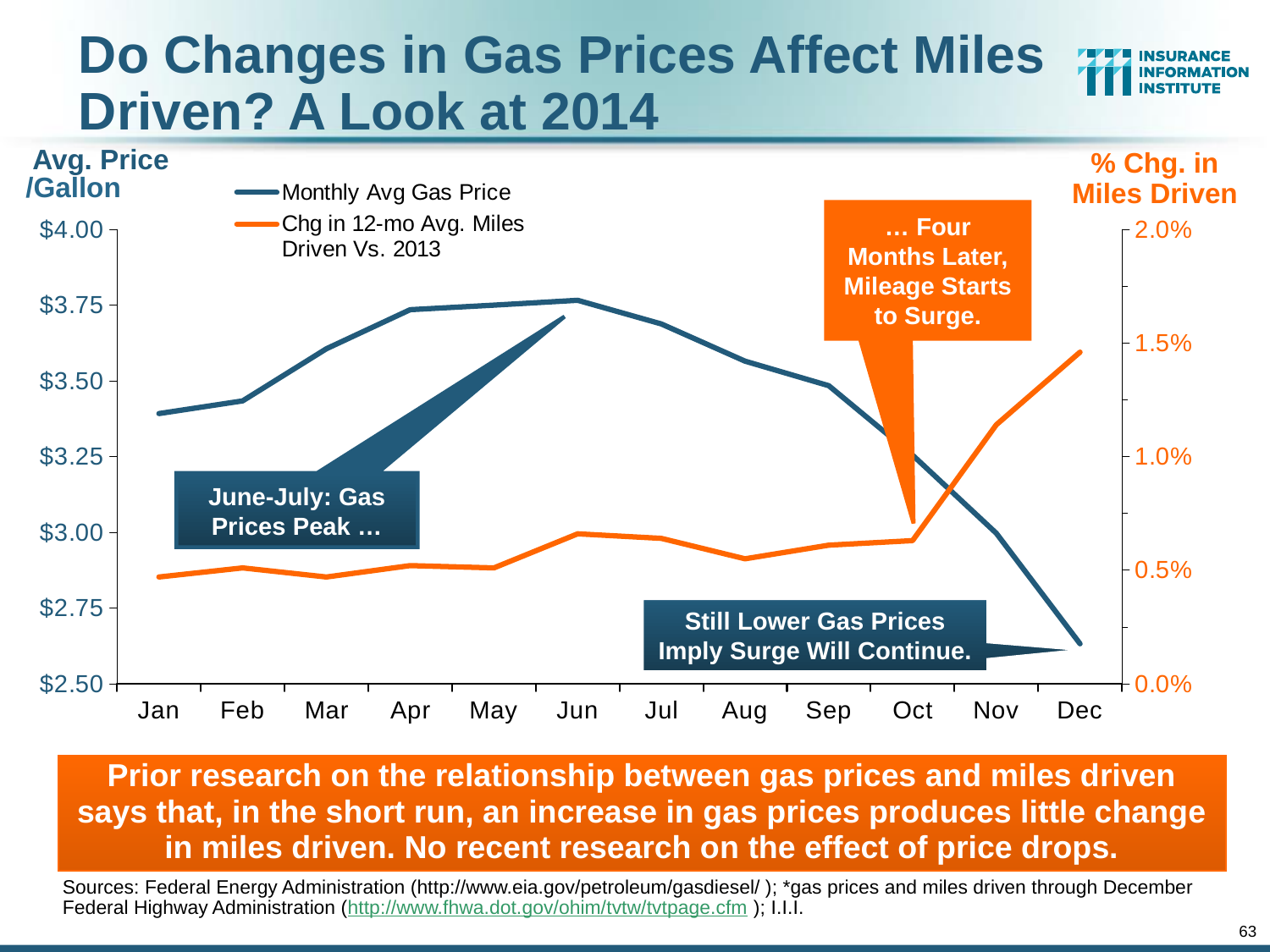
What kind of chart is shown on the slide? line chart Is the Chg in 12-mo Avg. Miles Driven Vs. 2013 for Oct greater or less than 1.0%? less How many series does the legend list? 2 Is the Chg in 12-mo Avg. Miles Driven Vs. 2013 for Dec greater or less than 1.0%? greater Which is larger, the Monthly Avg Gas Price in Jan or in Dec? Jan In which month is the Chg in 12-mo Avg. Miles Driven Vs. 2013 highest? Dec Does the Monthly Avg Gas Price rise or fall from Jun to Dec? fall Is the Monthly Avg Gas Price for Dec greater or less than $2.75? less In which month is the Monthly Avg Gas Price lowest? Dec What is the label of the right-hand vertical axis? % Chg. in Miles Driven How many months are plotted along the x axis? 12